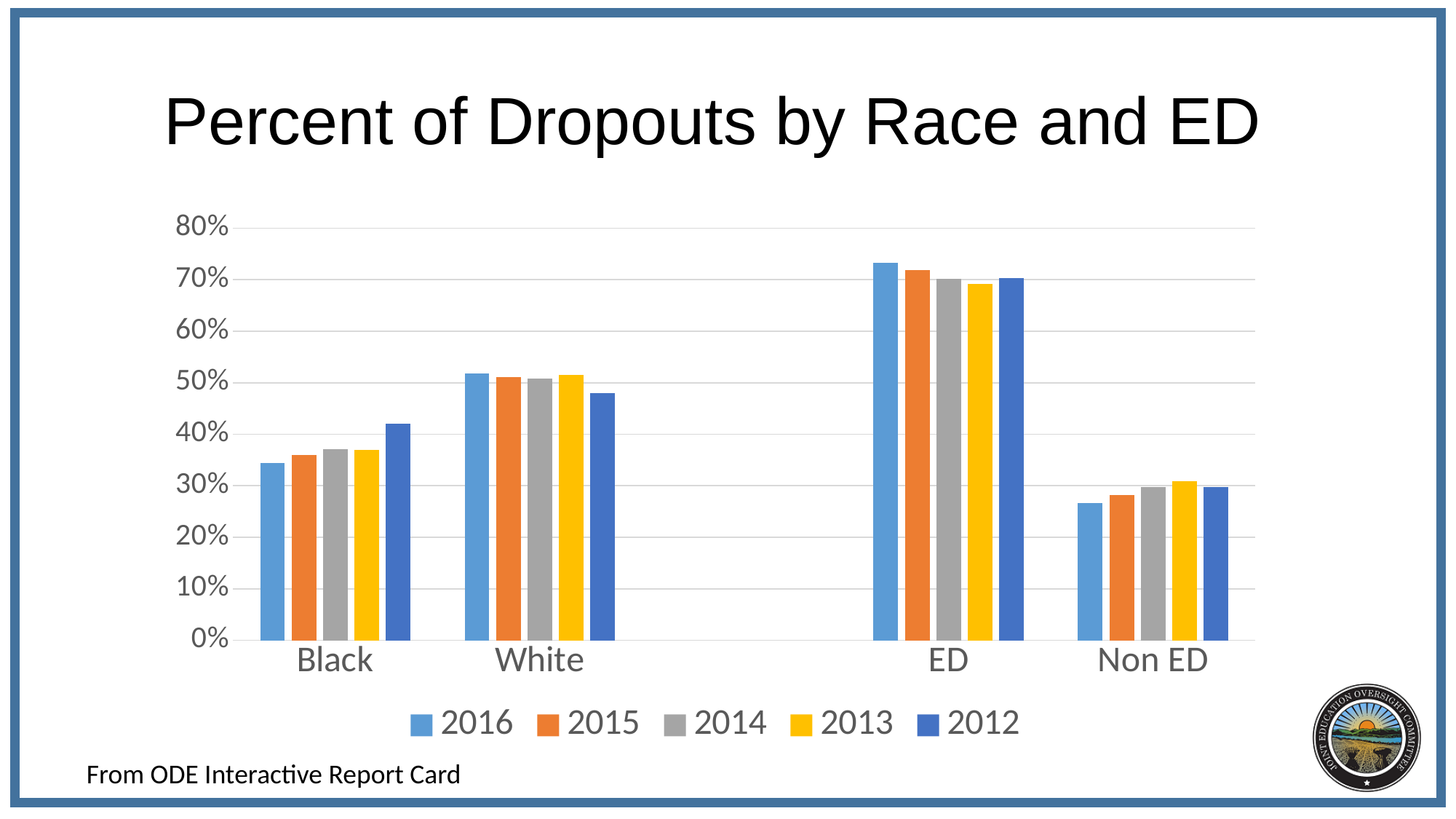
Is the 2016 value for ED greater or less than 70%? greater Which category has the lowest 2016 bar? Non ED What is the title of the chart? Percent of Dropouts by Race and ED Is the 2012 value for Black greater or less than 40%? greater What kind of chart is shown on the slide? Bar chart How many categories are shown on the x axis? 4 Is the 2012 value for White greater or less than 50%? less Within the Black group, do the bars rise or fall from 2016 on the left to 2012 on the right? rise Which category has the highest 2016 bar? ED Which is larger for Black: the 2012 value or the 2016 value? 2012 How many series does the legend list? 5